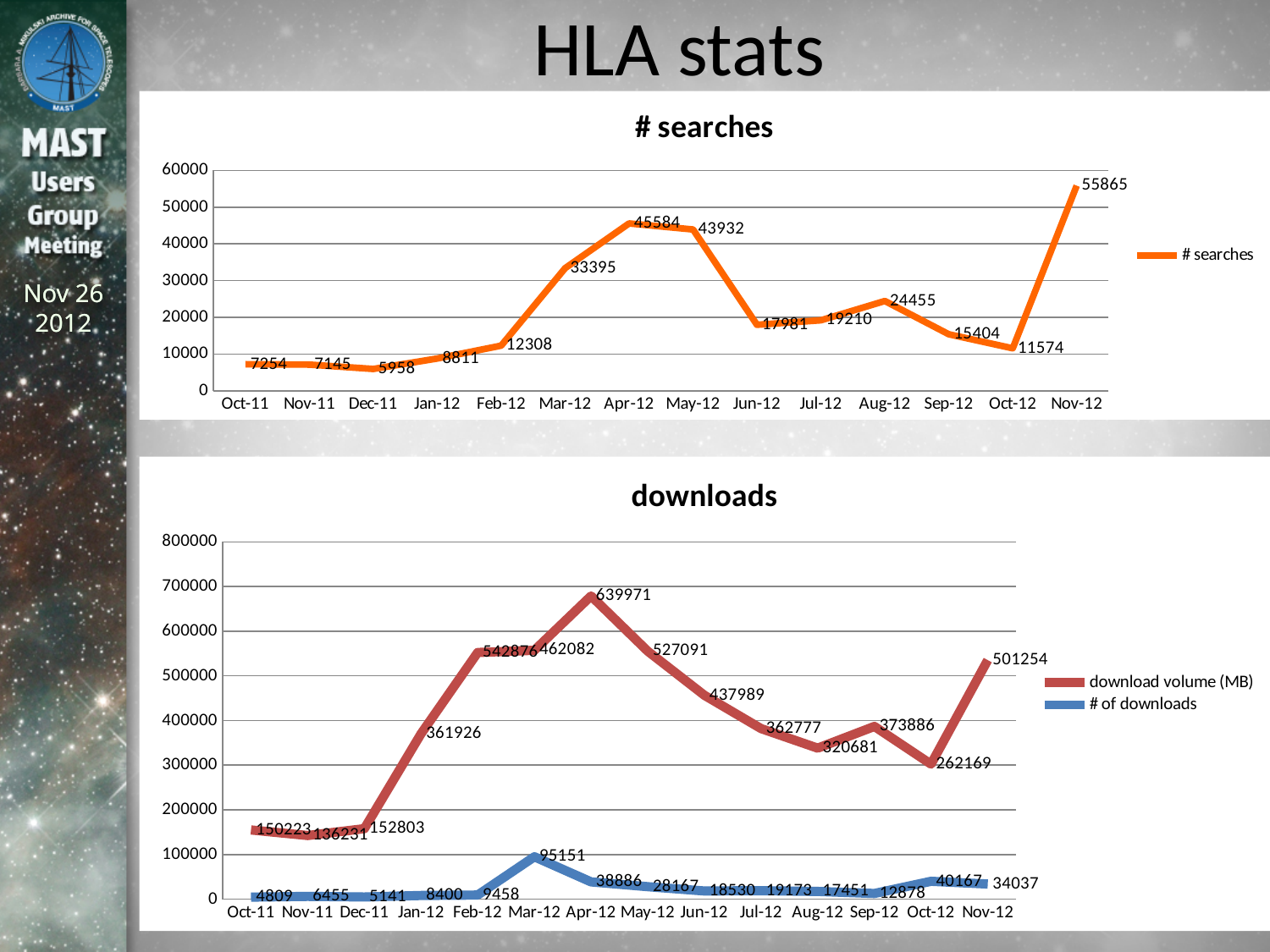
In the 'downloads' chart, what is the download volume (MB) for Apr-12? 639971 In the '# searches' chart, how many months are plotted along the x axis? 14 In the '# searches' chart, which month has the lowest number of searches? Dec-11 In the '# searches' chart, which is larger, the value for Jun-12 or Jul-12? Jul-12 In the '# searches' chart, which month has the highest number of searches? Nov-12 In the 'downloads' chart, is the download volume (MB) for Jan-12 greater or less than 400000? less In the '# searches' chart, what is the difference between the Apr-12 and May-12 values? 1652 What kind of chart is the '# searches' chart? Line chart In the 'downloads' chart, what is the # of downloads for Mar-12? 95151 In the 'downloads' chart, which month has the highest download volume (MB)? Apr-12 In the 'downloads' chart, how many series does the legend list? 2 In the '# searches' chart, what is the value for Nov-12? 55865